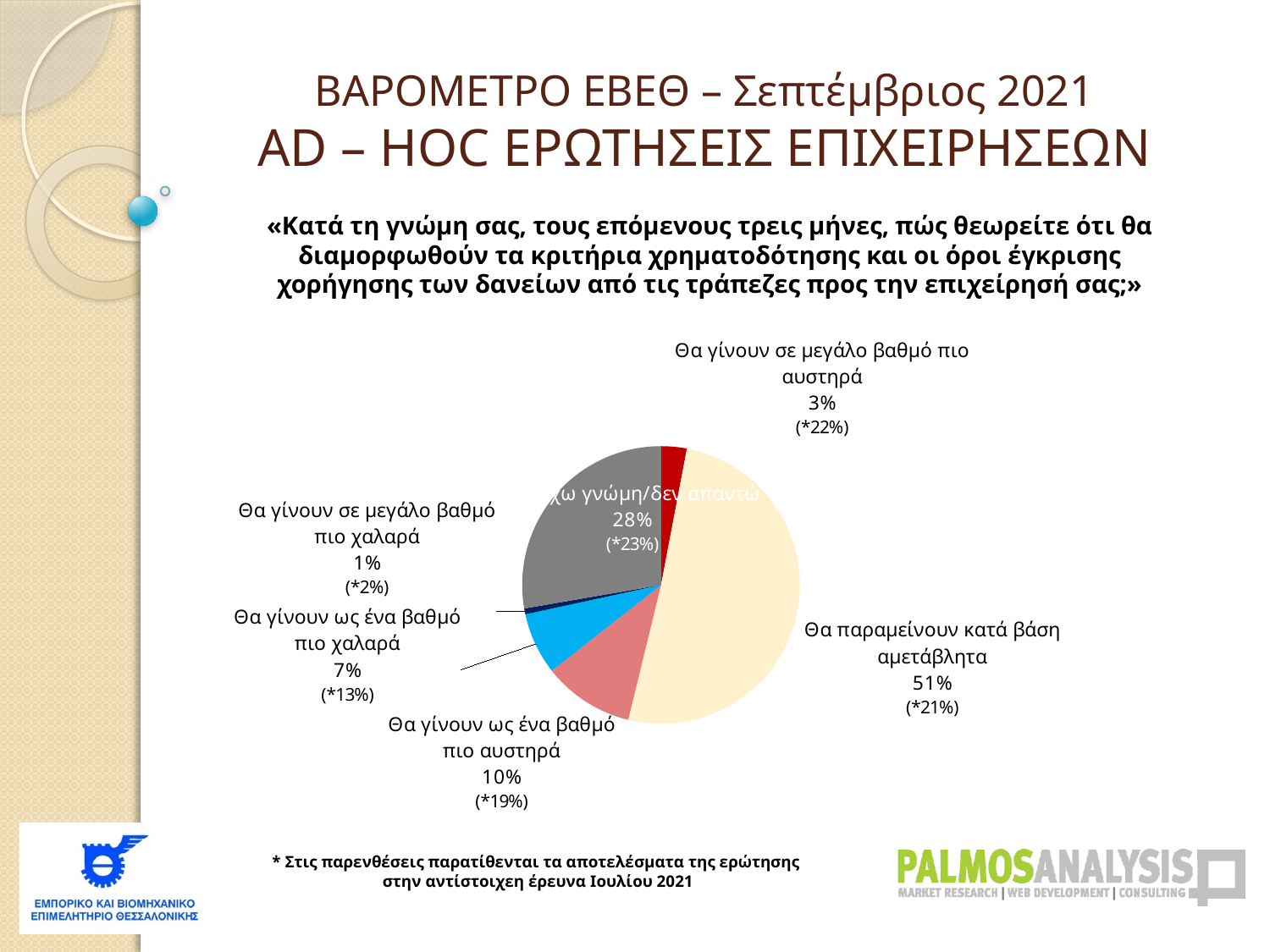
What kind of chart is shown on the slide? Pie chart What percentage is shown for "Θα παραμείνουν κατά βάση αμετάβλητα"? 51% Which is larger: "Θα γίνουν ως ένα βαθμό πιο αυστηρά" or "Θα γίνουν ως ένα βαθμό πιο χαλαρά"? Θα γίνουν ως ένα βαθμό πιο αυστηρά What percentage is shown for "Θα γίνουν ως ένα βαθμό πιο αυστηρά"? 10% What was the July 2021 value (in parentheses) for "Θα γίνουν σε μεγάλο βαθμό πιο αυστηρά"? 22% What is the difference in percentage points between "Θα παραμείνουν κατά βάση αμετάβλητα" (51%) and the "δεν απαντώ" slice (28%)? 23 percentage points What percentage is shown for "Θα γίνουν ως ένα βαθμό πιο χαλαρά"? 7% Which category has the smallest share of the pie? Θα γίνουν σε μεγάλο βαθμό πιο χαλαρά According to the footnote, what do the values in parentheses represent? The results of the same question in the July 2021 survey How many categories (slices) does the pie chart have? 6 Which category has the largest share of the pie? Θα παραμείνουν κατά βάση αμετάβλητα What percentage is shown for "Θα γίνουν σε μεγάλο βαθμό πιο αυστηρά"? 3%